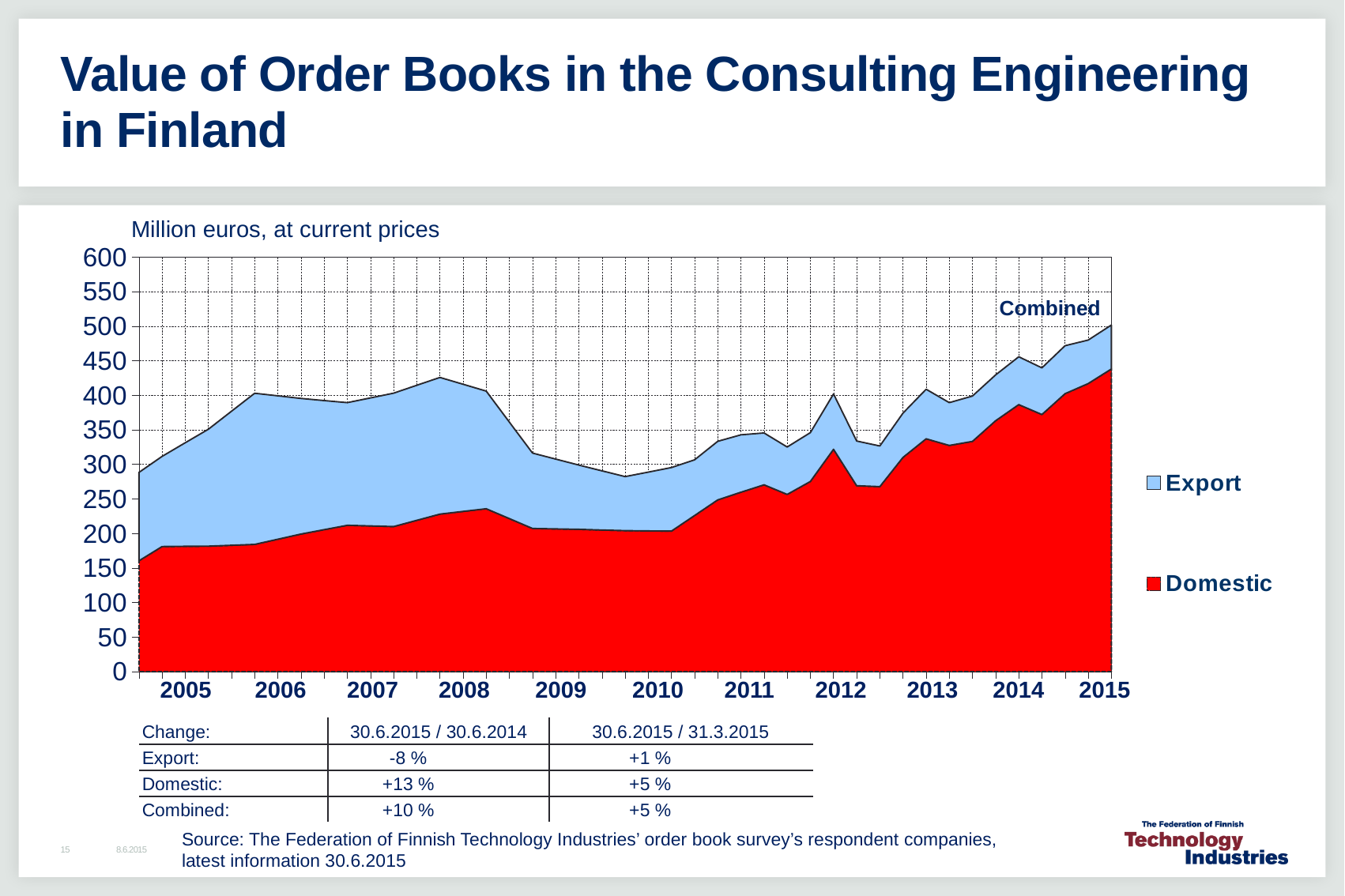
What kind of chart is shown on the slide? Stacked area chart Is the Combined value at the 2008 peak greater or less than 400? greater What unit is the chart measured in, according to the label above it? Million euros, at current prices Which two series are listed in the legend? Export and Domestic Is the Domestic value in 2010 greater or less than 250? less How many years are labelled on the x axis? 11 Is the Combined value in 2010 greater or less than 350? less Does the Domestic value rise or fall from 2010 to 2015? rise How many series does the legend list? 2 Does the Combined value rise or fall from 2008 to 2010? fall According to the change table, what is the Export change for 30.6.2015 / 30.6.2014? -8 %